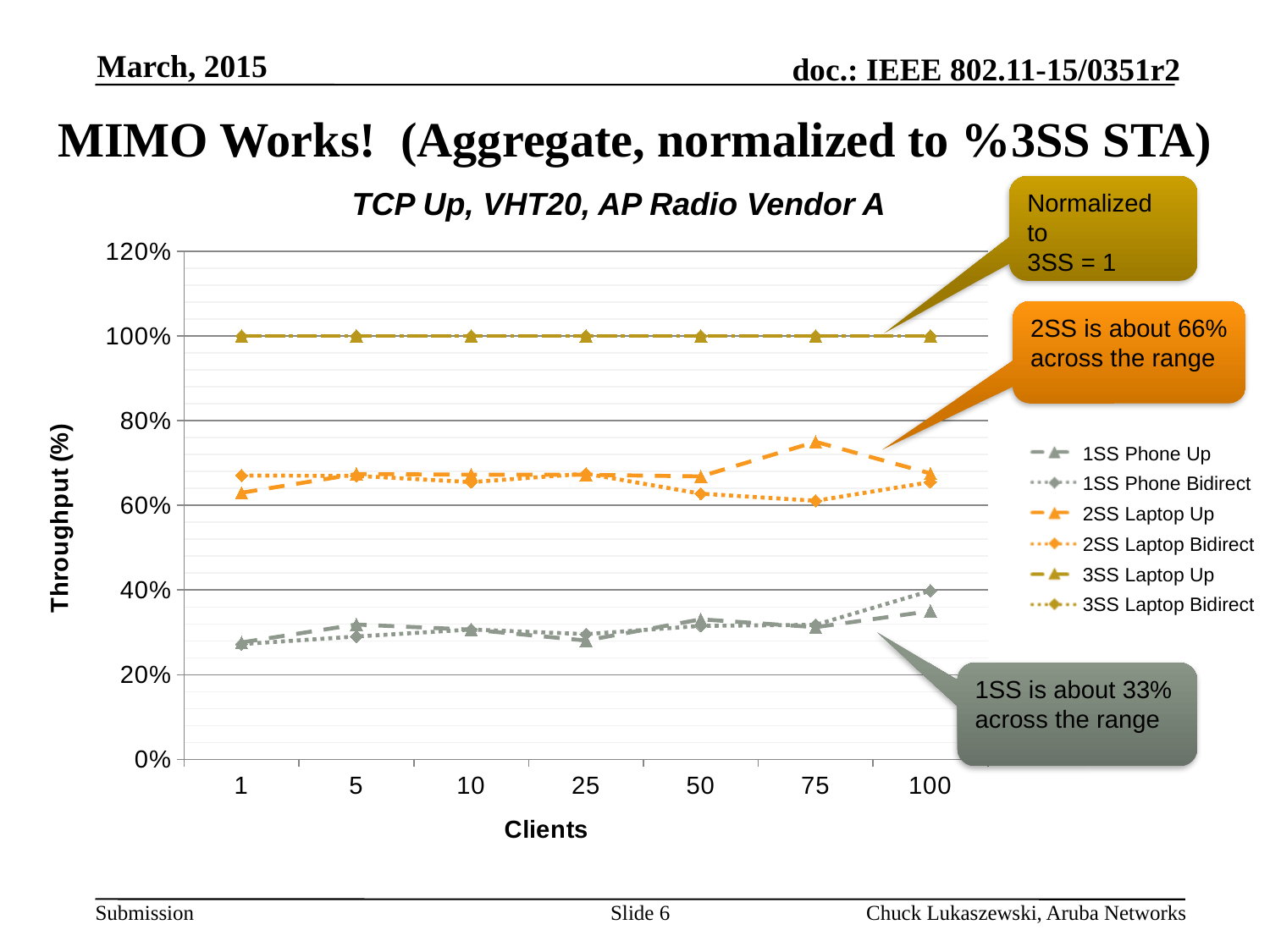
How many series does the legend list? 6 Is the value for 2SS Laptop Bidirect at 75 clients greater or less than 80%? less Is the value for 2SS Laptop Up at 75 clients greater or less than 60%? greater Does the 3SS Laptop Up series rise, fall, or stay flat as the number of clients increases? stays flat What is the title of the chart? TCP Up, VHT20, AP Radio Vendor A At 50 clients, which is larger: 2SS Laptop Up or 1SS Phone Up? 2SS Laptop Up Is the value for 1SS Phone Up at 1 client greater or less than 40%? less At 75 clients, which is higher: 2SS Laptop Up or 2SS Laptop Bidirect? 2SS Laptop Up What is the value of 3SS Laptop Up at 100 clients? 100% What is the label of the y axis? Throughput (%) How many client counts are plotted along the x axis? 7 What kind of chart is shown on the slide? line chart